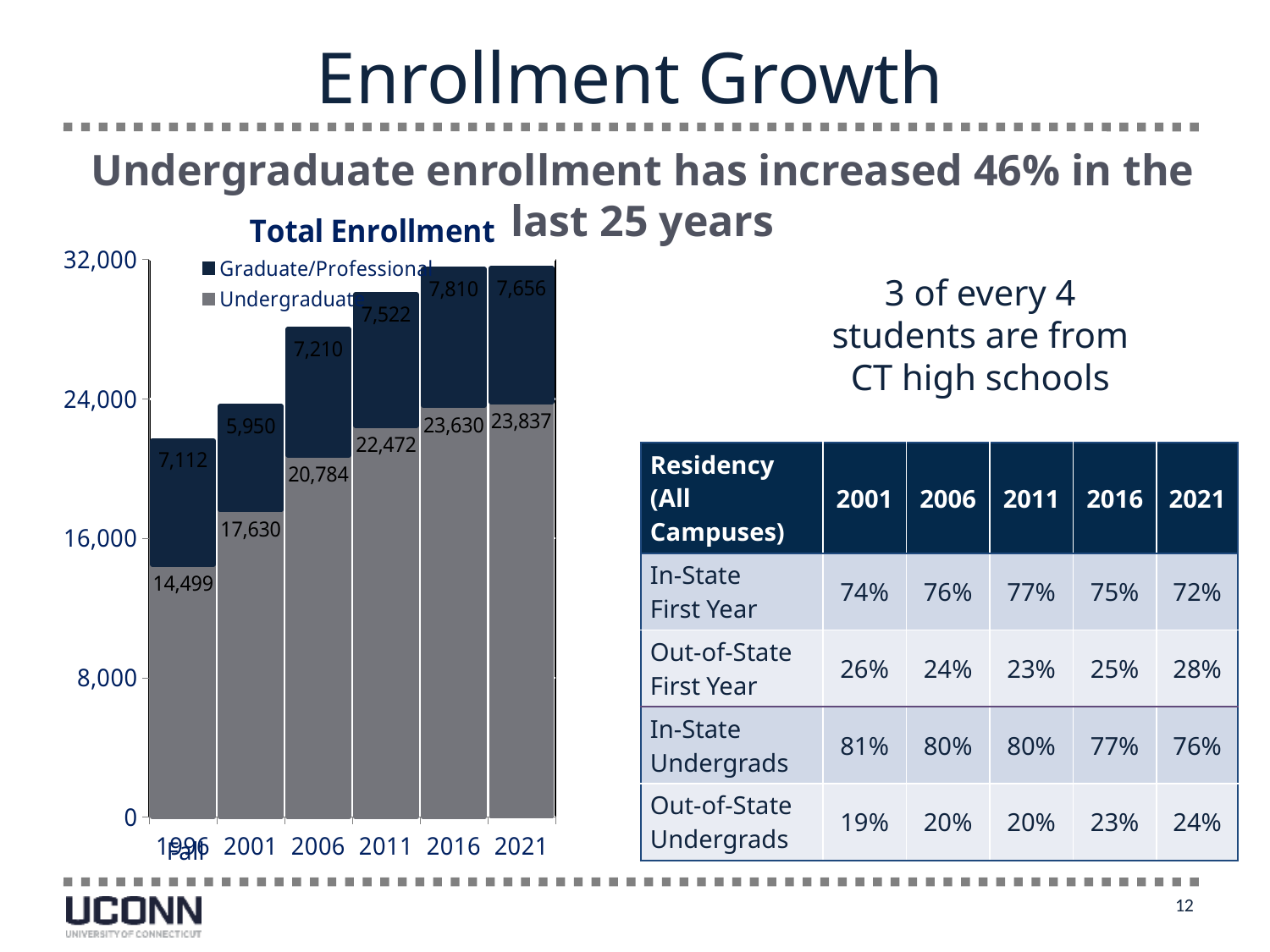
How many series does the legend of the Total Enrollment chart list? 2 How many years are shown on the x axis of the Total Enrollment chart? 6 What is the Graduate/Professional enrollment for 2011 in the Total Enrollment chart? 7,522 In the Total Enrollment chart, is Undergraduate enrollment larger in 2006 or 2011? 2011 What is the Undergraduate enrollment for 1996 in the Total Enrollment chart? 14,499 Which year has the highest Undergraduate enrollment in the Total Enrollment chart? 2021 Is the total enrollment for 2021 in the Total Enrollment chart greater or less than 24,000? greater What is the difference between Graduate/Professional enrollment in 2016 and 2001 in the Total Enrollment chart? 1,860 What type of chart is the Total Enrollment chart? Stacked bar chart What is the total enrollment for 2016 in the Total Enrollment chart? 31,440 By how much did Undergraduate enrollment increase from 1996 to 2021 in the Total Enrollment chart? 9,338 Which year has the lowest Graduate/Professional enrollment in the Total Enrollment chart? 2001